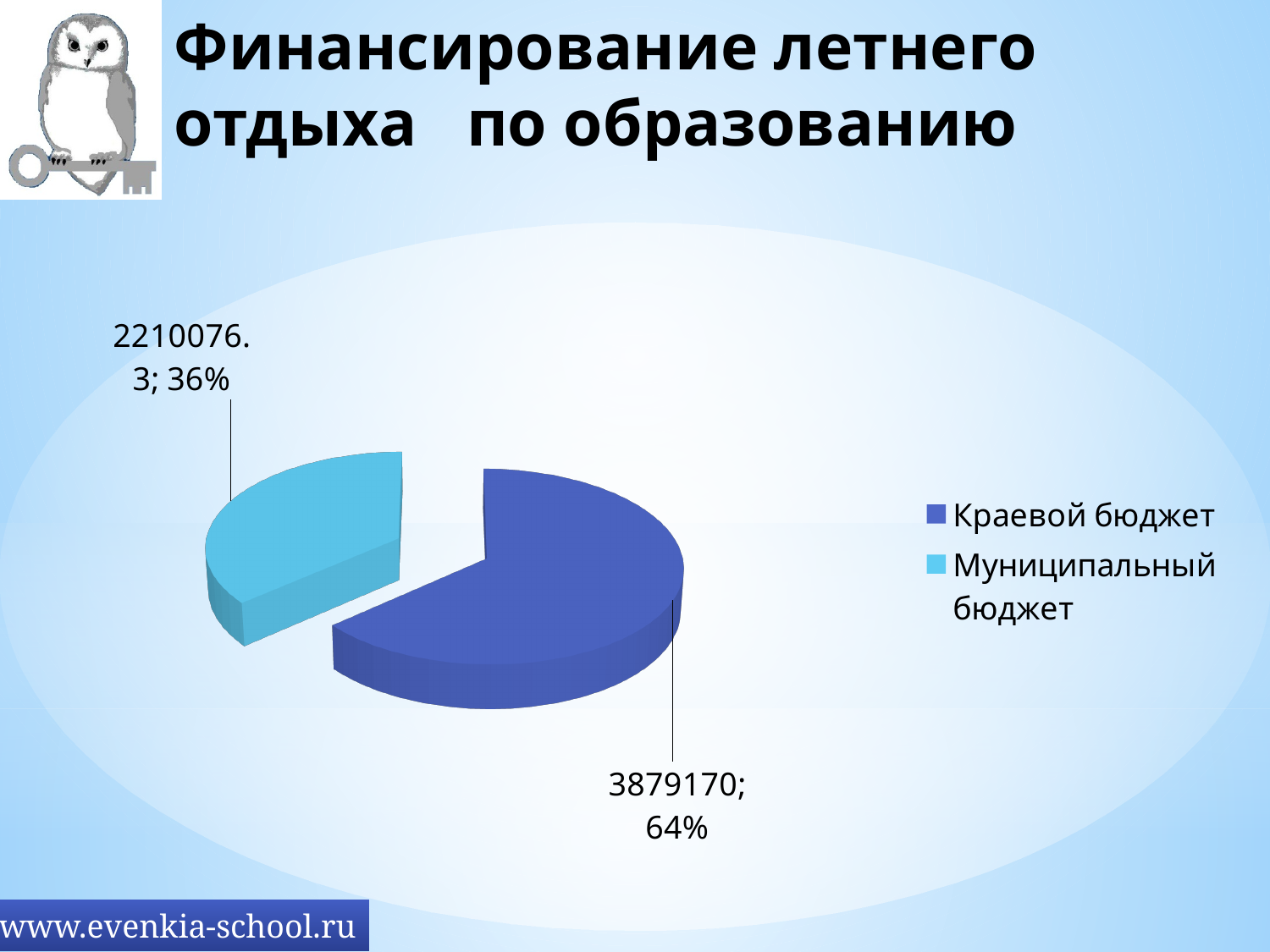
What colour is the slice for Муниципальный бюджет? Light blue What share of the pie does Краевой бюджет represent? 64% How many slices does the pie chart have? 2 Which is larger, Краевой бюджет or Муниципальный бюджет? Краевой бюджет What is the difference between the values for Краевой бюджет and Муниципальный бюджет? 1669093.7 What is the value for Муниципальный бюджет? 2210076.3 How many entries does the legend list? 2 Which slice is the largest? Краевой бюджет What kind of chart is shown on the slide? Pie chart What is the value for Краевой бюджет? 3879170 Which slice is the smallest? Муниципальный бюджет What share of the pie does Муниципальный бюджет represent? 36%